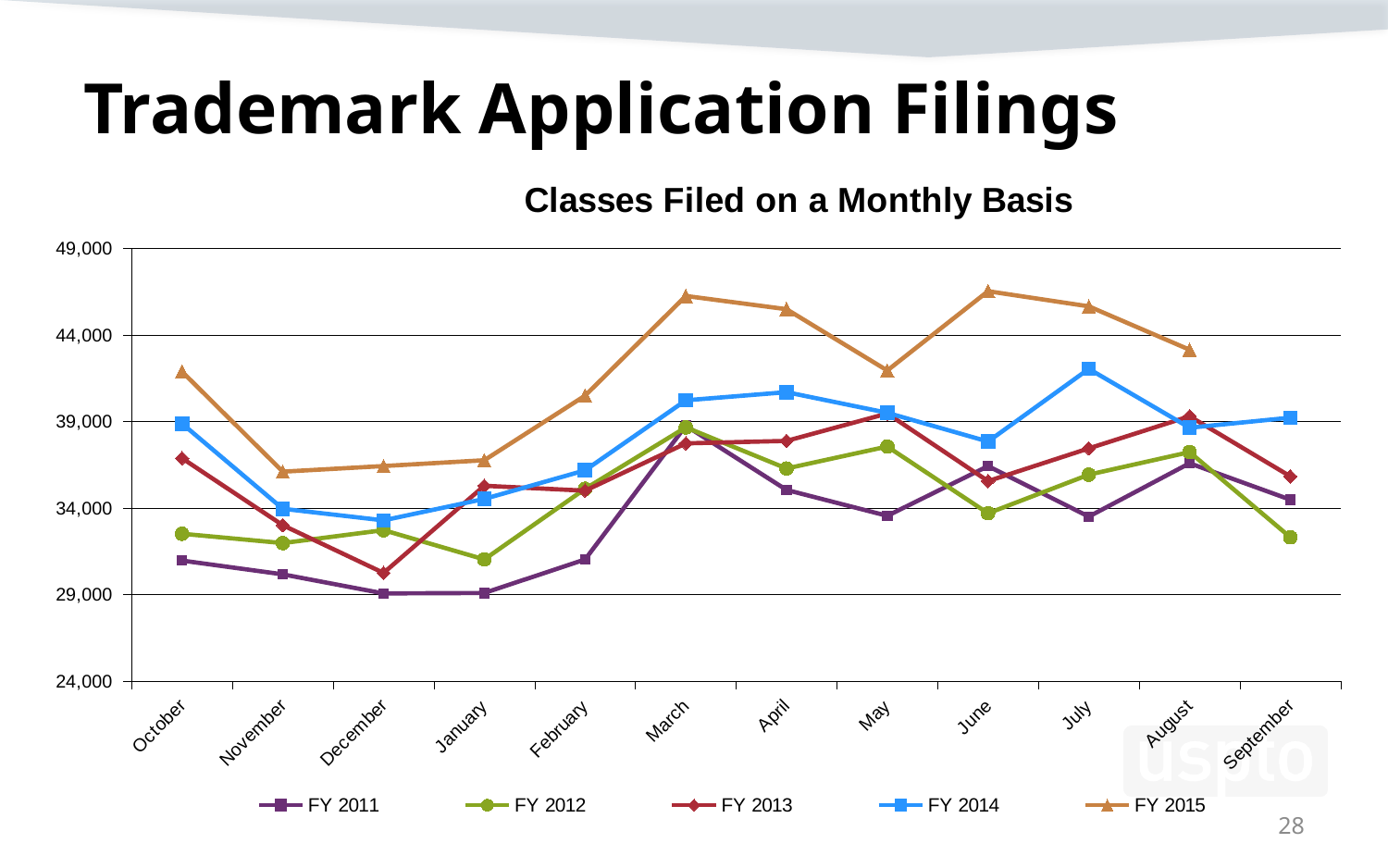
How many series does the legend list? 5 In October, which series has the higher value, FY 2015 or FY 2014? FY 2015 Is the FY 2012 value for January greater or less than 34,000? less Does the FY 2015 series rise or fall from October to November? fall Is the FY 2014 value for July greater or less than 39,000? greater In September, which series has the higher value, FY 2014 or FY 2012? FY 2014 What kind of chart is shown on the slide? Line chart In which month does the FY 2013 series reach its lowest value? December Is the FY 2015 value for March greater or less than 44,000? greater Which series has the lowest value in October? FY 2011 In which month does the FY 2014 series reach its highest value? July How many months are shown along the x axis? 12